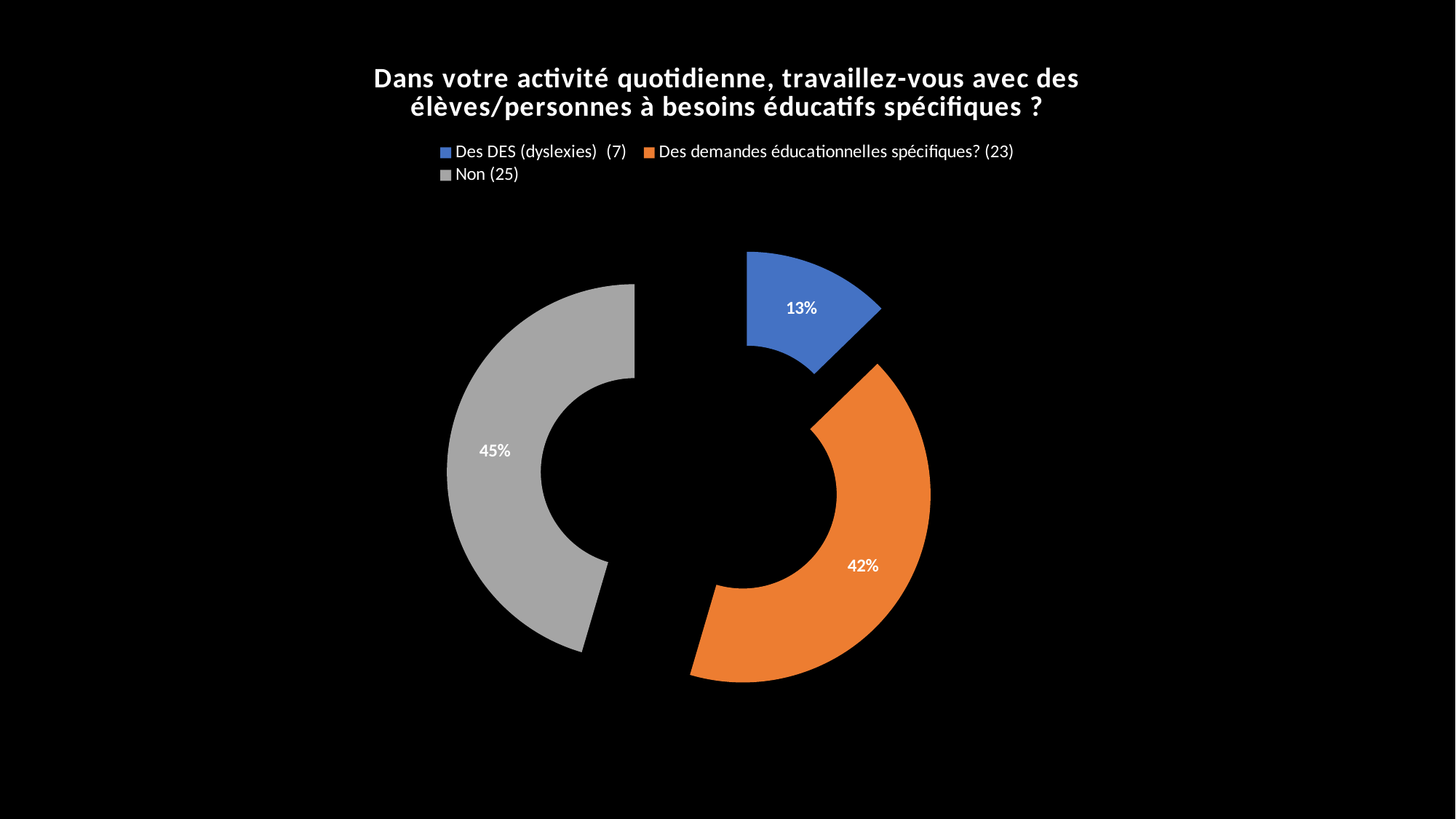
What is the difference in percentage points between the 'Non' slice and the 'Des DES (dyslexies)' slice? 32 How many categories are shown in the chart? 3 What percentage share does the 'Des DES (dyslexies) (7)' slice have? 13% Which is larger: the share for 'Des demandes éducationnelles spécifiques?' or the share for 'Des DES (dyslexies)'? Des demandes éducationnelles spécifiques? Which category has the largest share of the chart? Non (25) What percentage share does the 'Non (25)' slice have? 45% What colour is the slice representing 'Non (25)'? Grey What is the difference in percentage points between the 'Non' slice and the 'Des demandes éducationnelles spécifiques?' slice? 3 What percentage share does the 'Des demandes éducationnelles spécifiques? (23)' slice have? 42% Which category has the smallest share of the chart? Des DES (dyslexies) (7) How many respondents are indicated in the legend for 'Des demandes éducationnelles spécifiques?'? 23 What kind of chart is shown on the slide? Doughnut chart